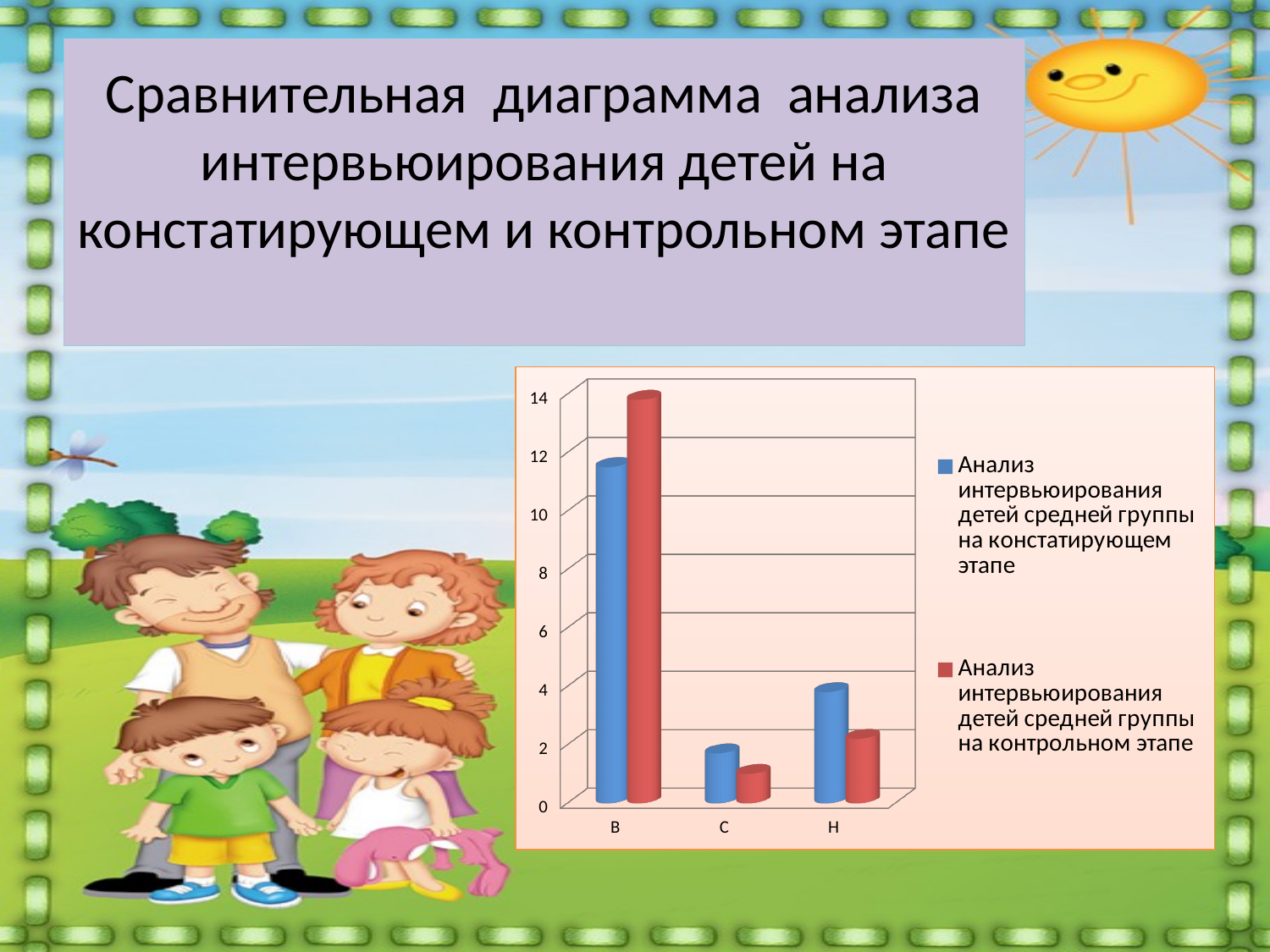
What kind of chart is shown on the slide? bar chart Is the value for category С in the series 'на контрольном этапе' greater or less than 2? less What colour are the bars for the series 'Анализ интервьюирования детей средней группы на контрольном этапе'? red For category В, which series has the larger value: 'на констатирующем этапе' or 'на контрольном этапе'? на контрольном этапе Is the value for category В in the series 'на контрольном этапе' greater or less than 12? greater How many categories are shown on the x axis of the chart? 3 Which category has the highest value for the series 'Анализ интервьюирования детей средней группы на констатирующем этапе'? В Is the value for category В in the series 'на констатирующем этапе' greater or less than 10? greater Which category has the lowest value for the series 'Анализ интервьюирования детей средней группы на контрольном этапе'? С How many series does the chart legend list? 2 For category Н, which series has the larger value: 'на констатирующем этапе' or 'на контрольном этапе'? на констатирующем этапе